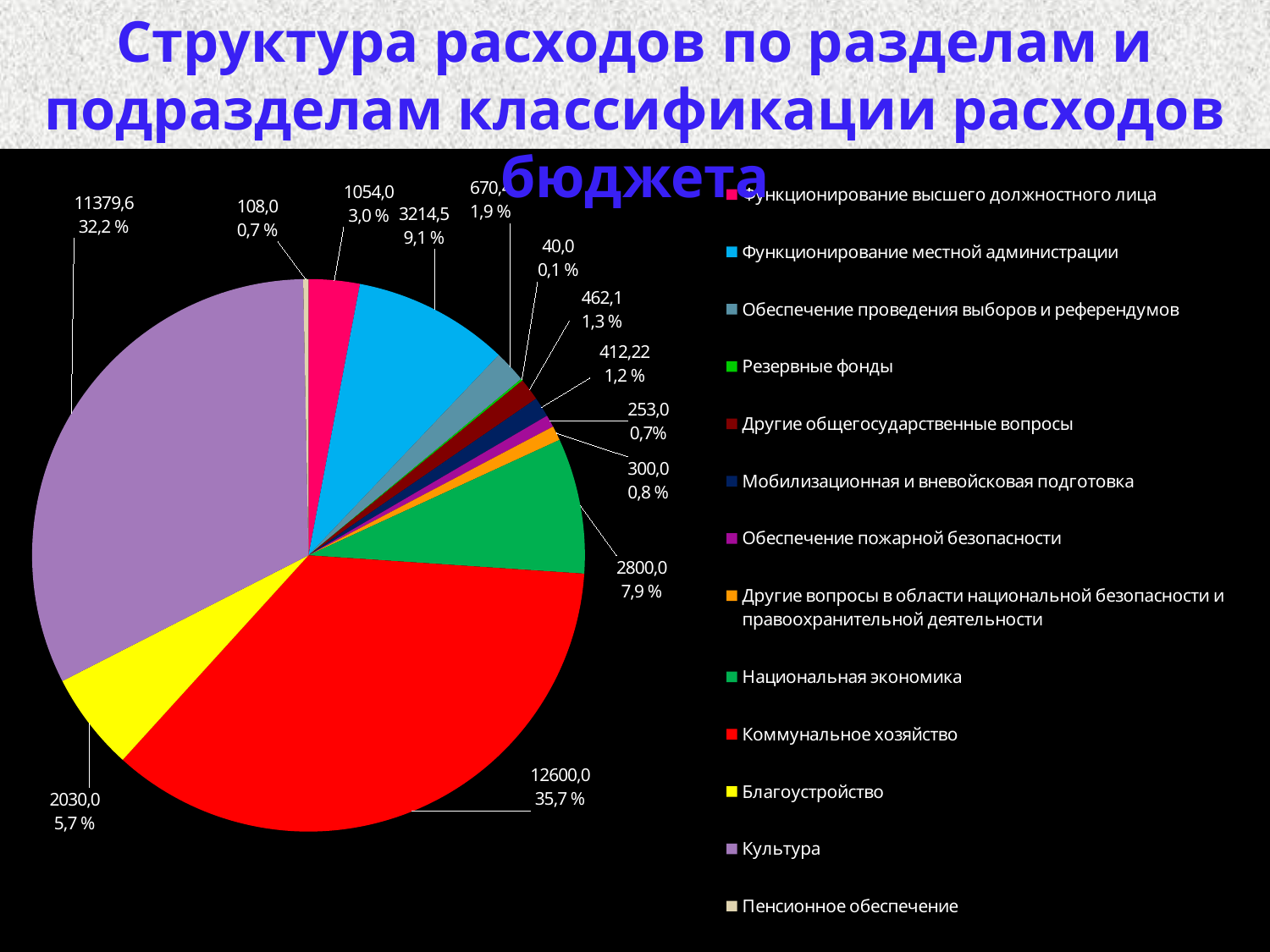
What colour is the slice for Благоустройство? yellow Which category has the smallest slice of the pie? Резервные фонды What value is shown for Благоустройство? 2030,0 What share of the pie does Культура take? 32,2 % What value is shown for Коммунальное хозяйство? 12600,0 What share of the pie does Национальная экономика take? 7,9 % What value is shown for Мобилизационная и вневойсковая подготовка? 412,22 Which is larger, the value for Функционирование местной администрации or the value for Национальная экономика? Функционирование местной администрации How many categories does the legend of the pie chart list? 13 Which category has the largest slice of the pie? Коммунальное хозяйство What is the difference between the values for Коммунальное хозяйство and Культура? 1220,4 What kind of chart is shown on the slide? pie chart